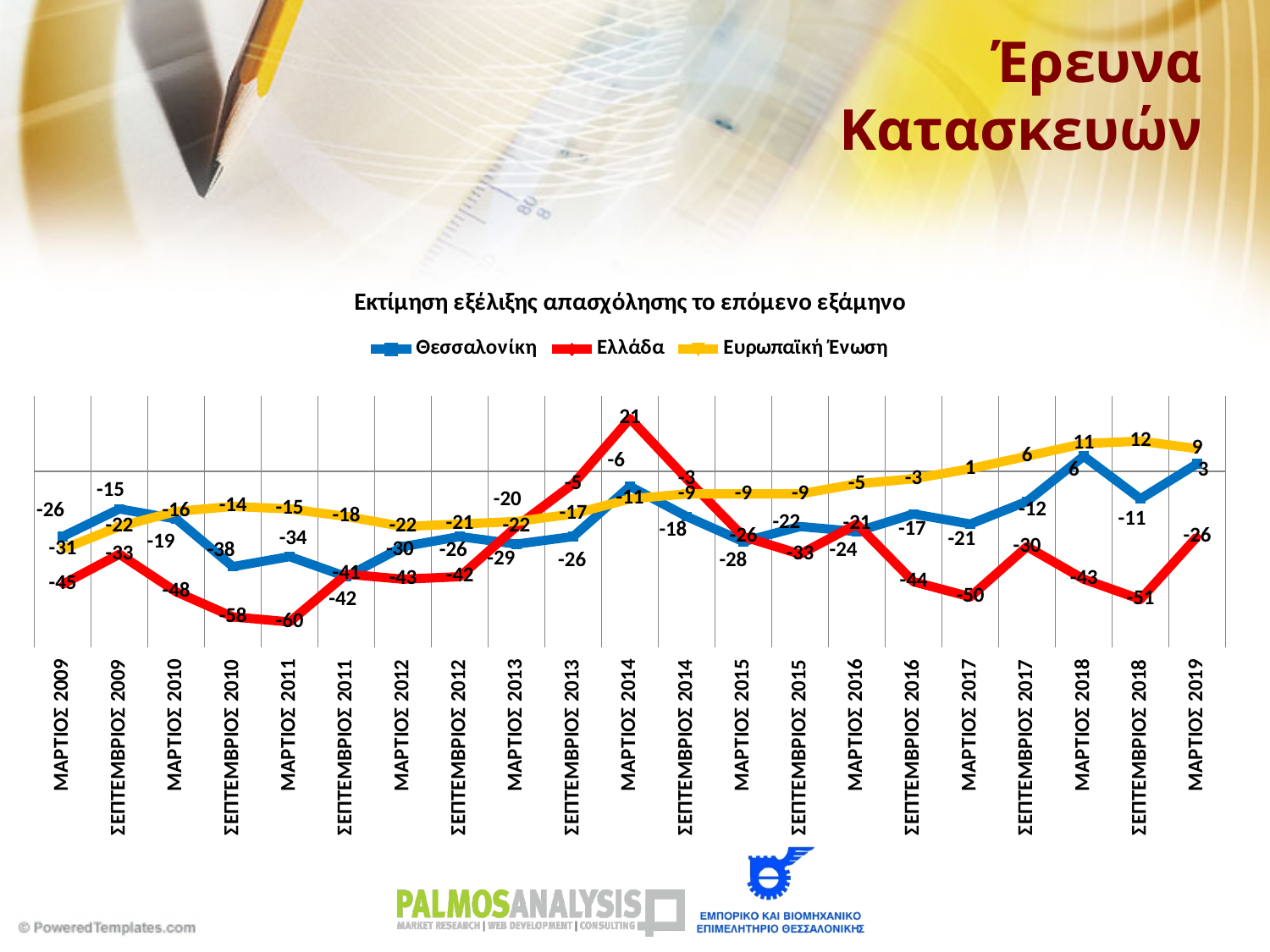
How many series does the legend list? 3 What is the title of the chart? Εκτίμηση εξέλιξης απασχόλησης το επόμενο εξάμηνο What is the value for Ελλάδα in ΜΑΡΤΙΟΣ 2014? 21 What is the difference between the Ελλάδα value in ΜΑΡΤΙΟΣ 2014 (21) and in ΜΑΡΤΙΟΣ 2011 (-60)? 81 In which period does the Ελλάδα series reach its lowest value? ΜΑΡΤΙΟΣ 2011 How many time points are plotted along the x axis? 21 In which period does the Ελλάδα series reach its highest value? ΜΑΡΤΙΟΣ 2014 What is the value for Ευρωπαϊκή Ένωση in ΣΕΠΤΕΜΒΡΙΟΣ 2018? 12 What is the value for Θεσσαλονίκη in ΜΑΡΤΙΟΣ 2009? -26 Which series has the higher value in ΜΑΡΤΙΟΣ 2017, Θεσσαλονίκη or Ελλάδα? Θεσσαλονίκη What kind of chart is shown on the slide? Line chart Does the Ευρωπαϊκή Ένωση series generally rise or fall from ΜΑΡΤΙΟΣ 2015 to ΣΕΠΤΕΜΒΡΙΟΣ 2018? Rise